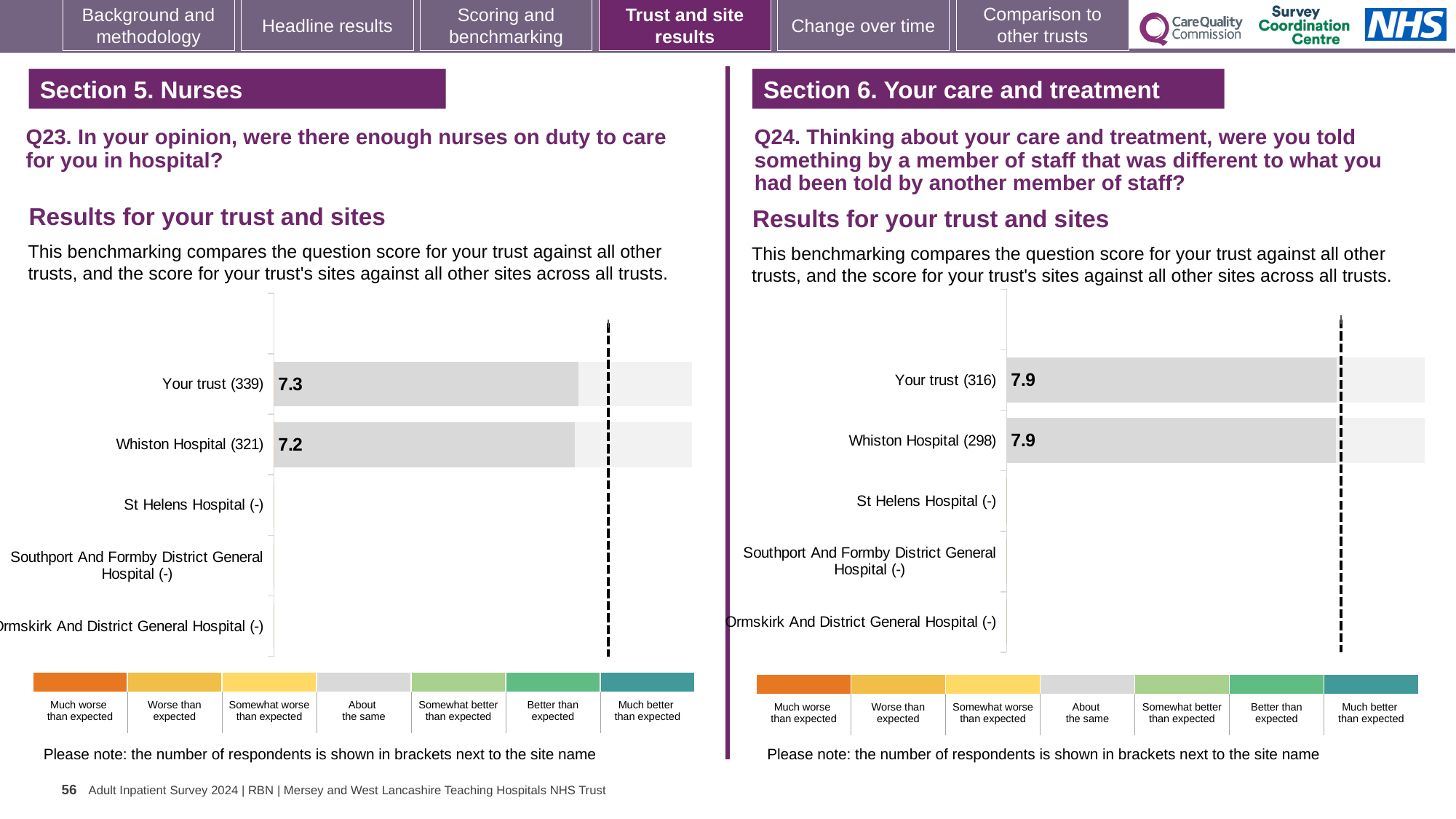
In the Q23 chart on the left, which has the higher score, Your trust or Whiston Hospital? Your trust In the Q24 chart on the right, how many categories in the colour key below the chart? 7 In the Q23 chart on the left, how many respondents are shown in brackets for Your trust? 339 In the Q24 chart on the right, what is the score for Your trust? 7.9 In the Q24 chart on the right, what is the score for Whiston Hospital? 7.9 What kind of chart is used for the Q24 results on the right? Bar chart In the Q23 chart on the left, what is the score for Your trust? 7.3 In the Q23 chart on the left, what is the difference between the score for Your trust and the score for Whiston Hospital? 0.1 In the Q24 chart on the right, how many respondents are shown in brackets for Whiston Hospital? 298 In the Q23 chart on the left, how many site or trust categories are listed on the vertical axis? 5 In the Q23 chart on the left, which sites show no score (marked with a dash)? St Helens Hospital, Southport And Formby District General Hospital, Ormskirk And District General Hospital In the Q23 chart on the left, what is the score for Whiston Hospital? 7.2